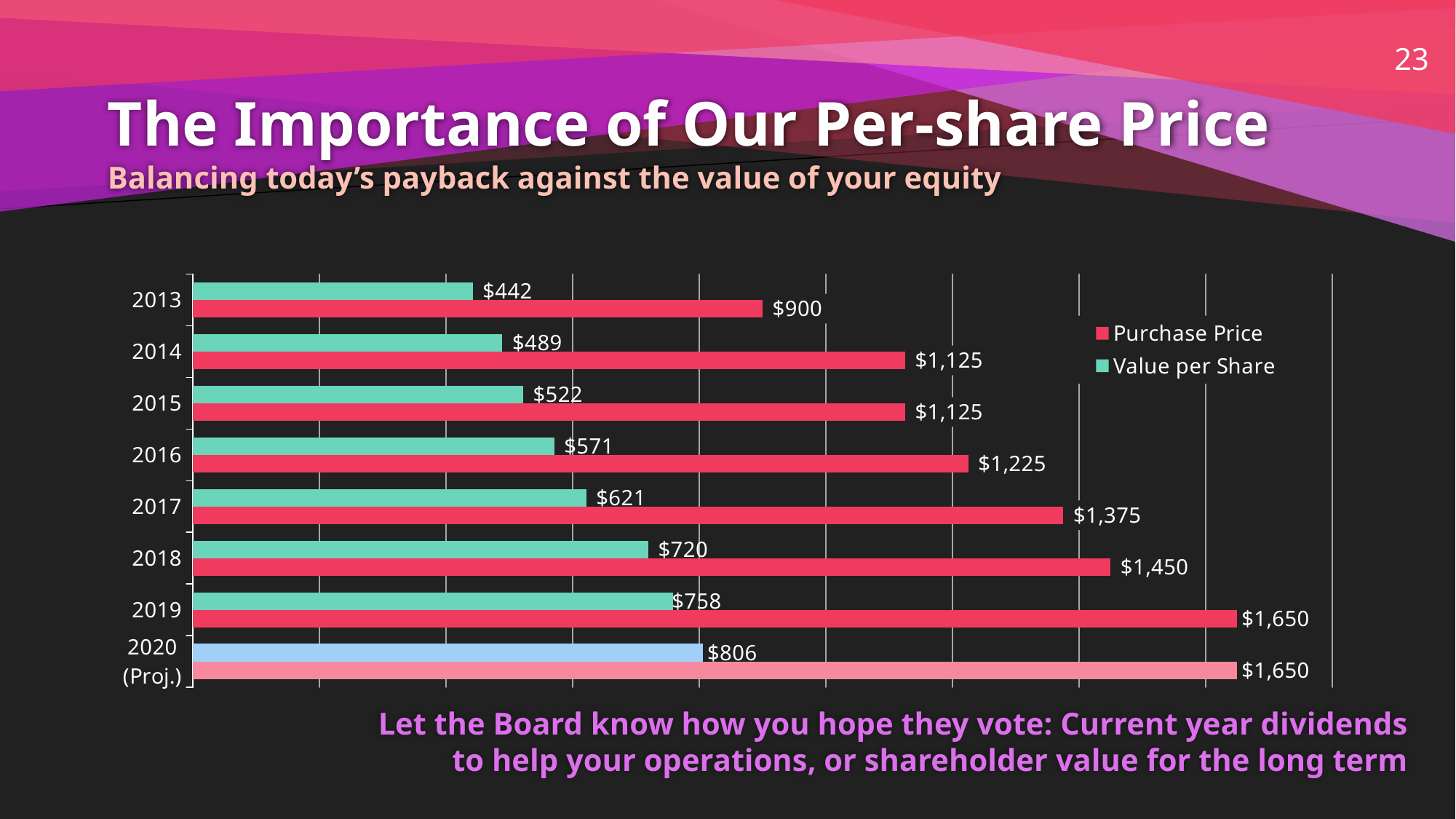
How many series does the legend list? 2 What is the difference between the Purchase Price and the Value per Share in 2018? $730 What is the Purchase Price for 2017? $1,375 What kind of chart is shown on the slide? Bar chart What is the Value per Share for 2014? $489 What is the Value per Share for 2020 (Proj.)? $806 How many years (categories) are shown on the chart? 8 Does the Value per Share rise or fall from 2013 to 2020 (Proj.)? Rise Which is larger, the Value per Share in 2016 or the Value per Share in 2017? 2017 By how much did the Purchase Price increase from 2013 to 2014? $225 Which year has the lowest Purchase Price? 2013 Which year has the highest Value per Share? 2020 (Proj.)